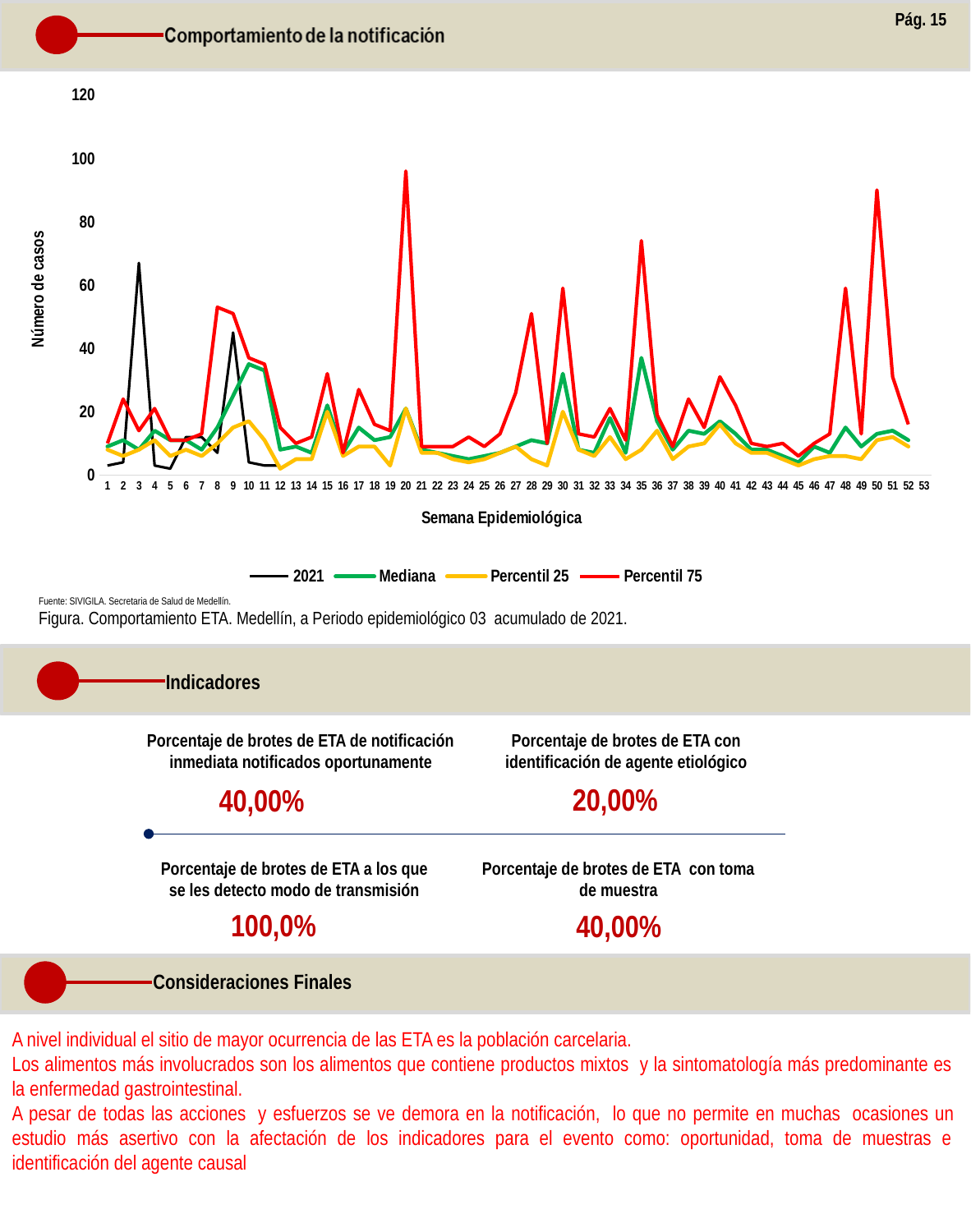
Is the Percentil 75 value at week 35 greater or less than 60? greater How many series does the chart legend list? 4 How many epidemiological weeks are shown on the x axis of the chart? 53 Is the 2021 value at week 3 greater or less than 60? greater What kind of chart is shown on the slide? Line chart Is the Percentil 75 value at week 50 greater or less than 80? greater Which series in the chart is drawn with a black line? 2021 What is the label of the y axis of the chart? Número de casos Which series reaches the highest value anywhere in the chart? Percentil 75 At which week does the Percentil 75 series reach its highest value? 20